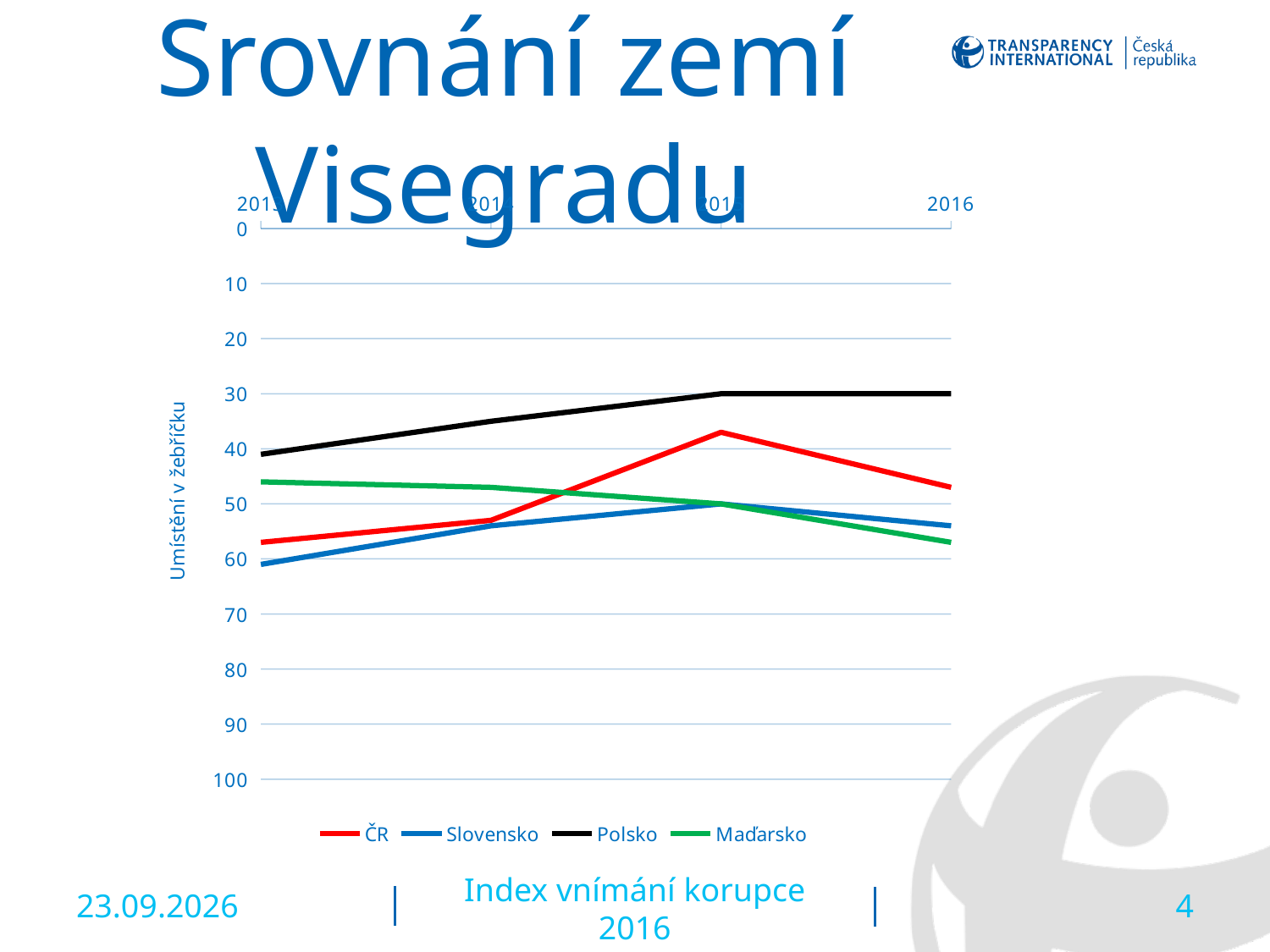
Which countries are listed in the chart legend? ČR, Slovensko, Polsko, Maďarsko How many data points does each line have? 4 What kind of chart is shown on the slide? line chart Is the value for ČR in 2016 greater or less than 50? less Which series has the lowest value in 2016? Polsko What is the title of the vertical axis? Umístění v žebříčku What is the value for Polsko in 2016? 30 Do the values for Polsko rise or fall from the first year to 2016? fall Is the value for Slovensko in 2016 greater or less than 50? greater In 2016, which has the larger plotted value, Polsko or Maďarsko? Maďarsko How many series does the legend list? 4 Is the value for Maďarsko in 2016 greater or less than 50? greater